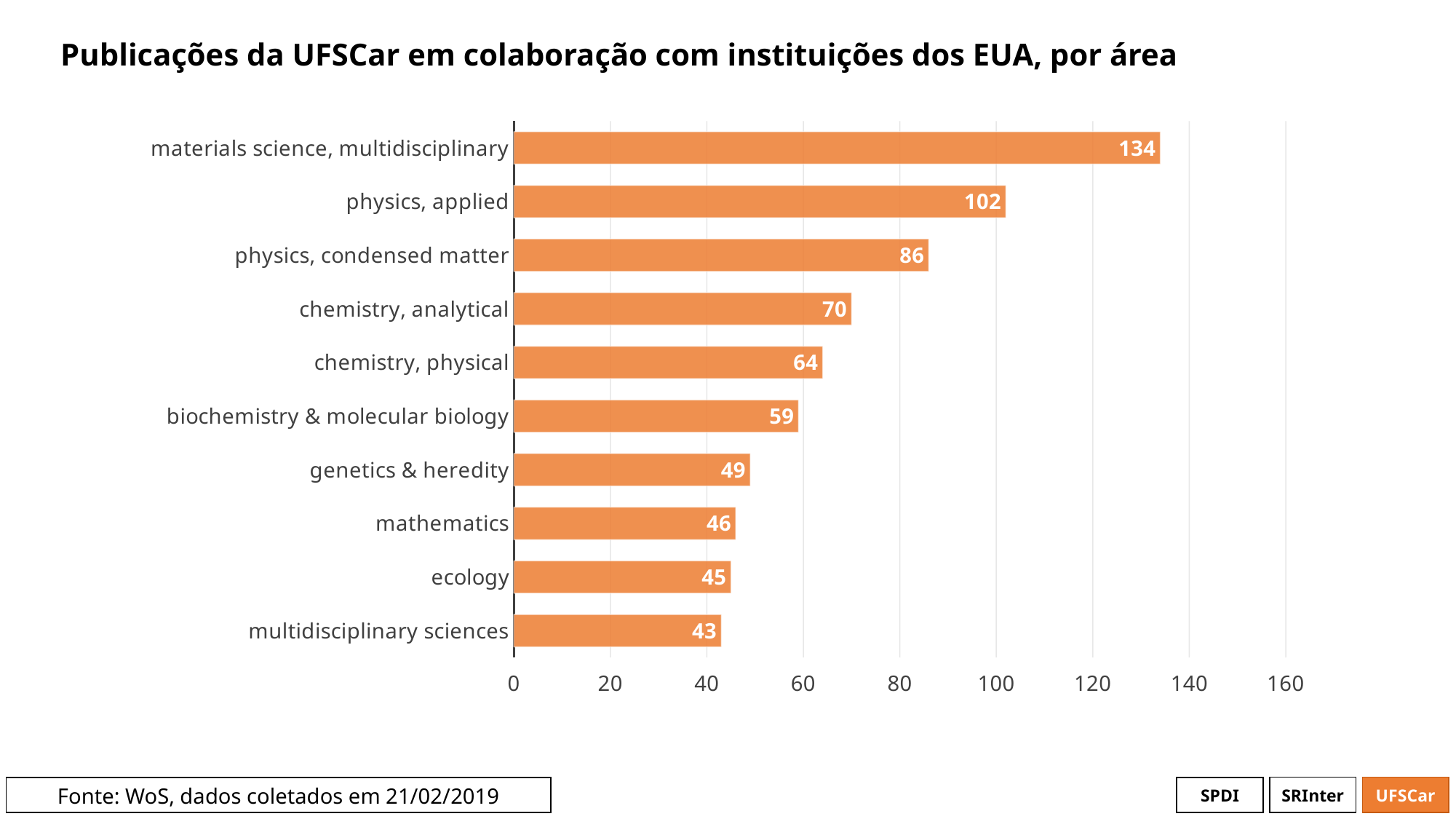
How many areas are shown in the chart? 10 Which area has the highest number of publications? materials science, multidisciplinary What is the value for ecology? 45 Is the value for physics, condensed matter greater or less than 80? greater What is the difference between chemistry, physical and biochemistry & molecular biology? 5 Which is larger, genetics & heredity or mathematics? genetics & heredity What kind of chart is shown on the slide? bar chart Which area has the lowest number of publications? multidisciplinary sciences What is the difference between materials science, multidisciplinary and physics, applied? 32 What is the title of the chart? Publicações da UFSCar em colaboração com instituições dos EUA, por área What is the value for chemistry, analytical? 70 What is the value for physics, applied? 102